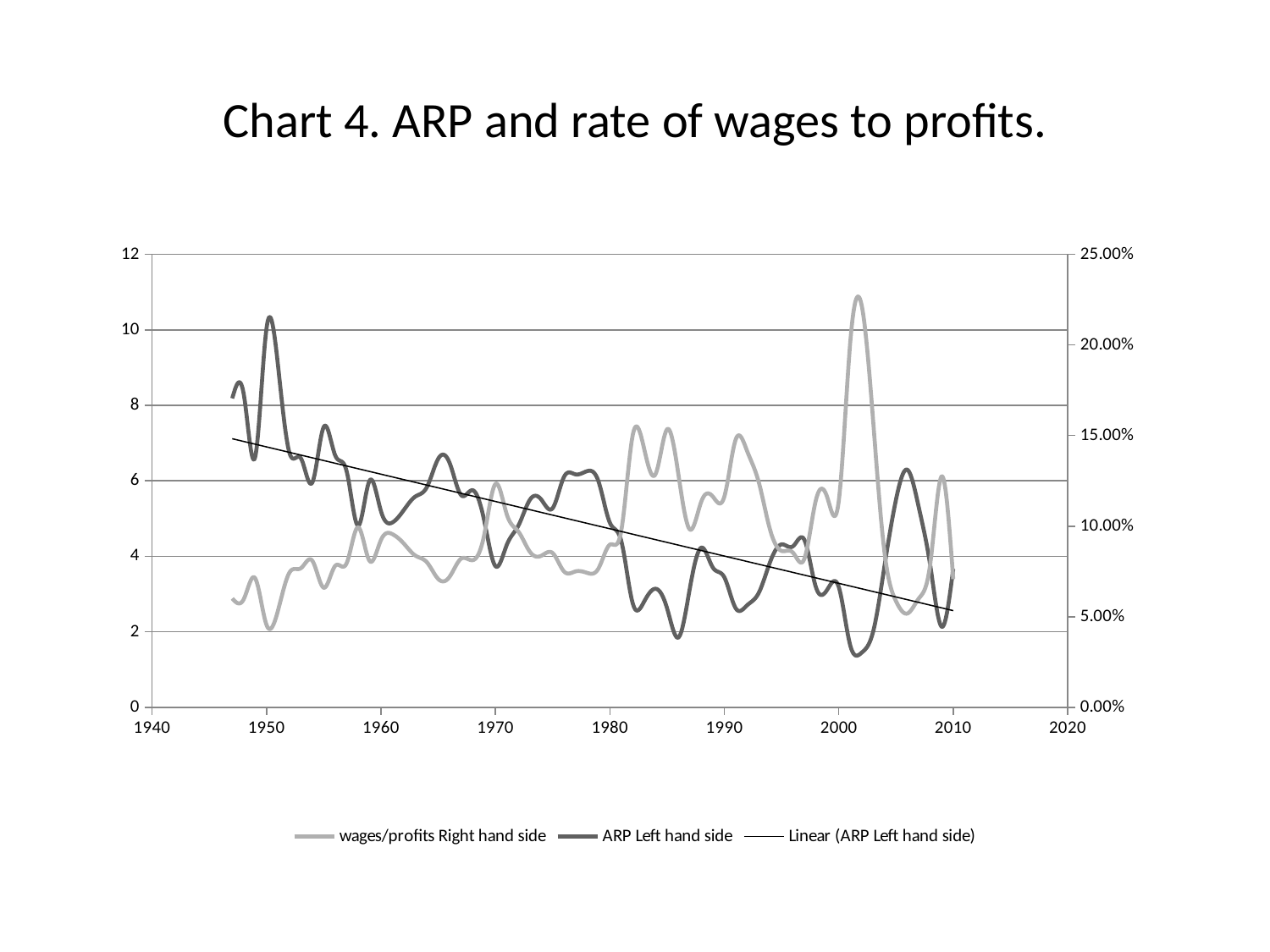
Is the value of ARP Left hand side around 1986 greater or less than 4? less Does the linear trendline for ARP (Left hand side) rise or fall from 1947 to 2010? fall Is the peak value of wages/profits Right hand side around 2002 greater or less than 20.00%? greater Is the peak value of ARP Left hand side around 1950 greater or less than 8? greater What kind of chart is shown on the slide? line chart What is the title of the chart? Chart 4. ARP and rate of wages to profits. Overall, does the ARP Left hand side series rise or fall between 1950 and 2010? fall How many entries does the legend list? 3